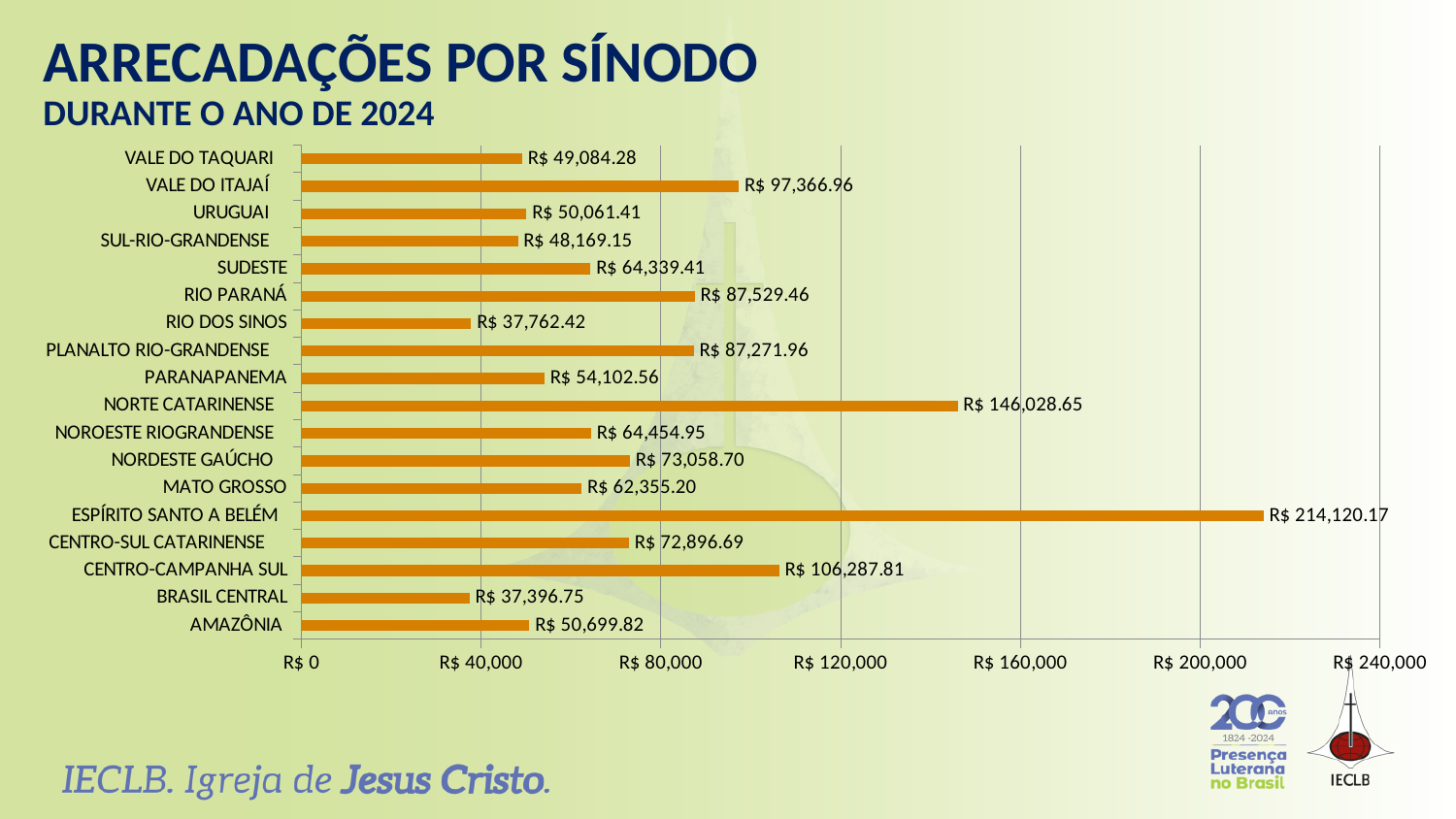
Is the value for CENTRO-CAMPANHA SUL greater or less than R$ 80,000? greater What is the difference between the values for VALE DO ITAJAÍ and VALE DO TAQUARI? R$ 48,282.68 Which is larger, the value for RIO PARANÁ or the value for SUDESTE? RIO PARANÁ What is the difference between the values for ESPÍRITO SANTO A BELÉM and NORTE CATARINENSE? R$ 68,091.52 What is the value for RIO DOS SINOS? R$ 37,762.42 What is the value for CENTRO-CAMPANHA SUL? R$ 106,287.81 What kind of chart is shown on the slide? bar chart How many sínodos are shown in the chart? 18 What is the value for NORTE CATARINENSE? R$ 146,028.65 Which sínodo has the highest value? ESPÍRITO SANTO A BELÉM Which sínodo has the lowest value? BRASIL CENTRAL What is the value for AMAZÔNIA? R$ 50,699.82